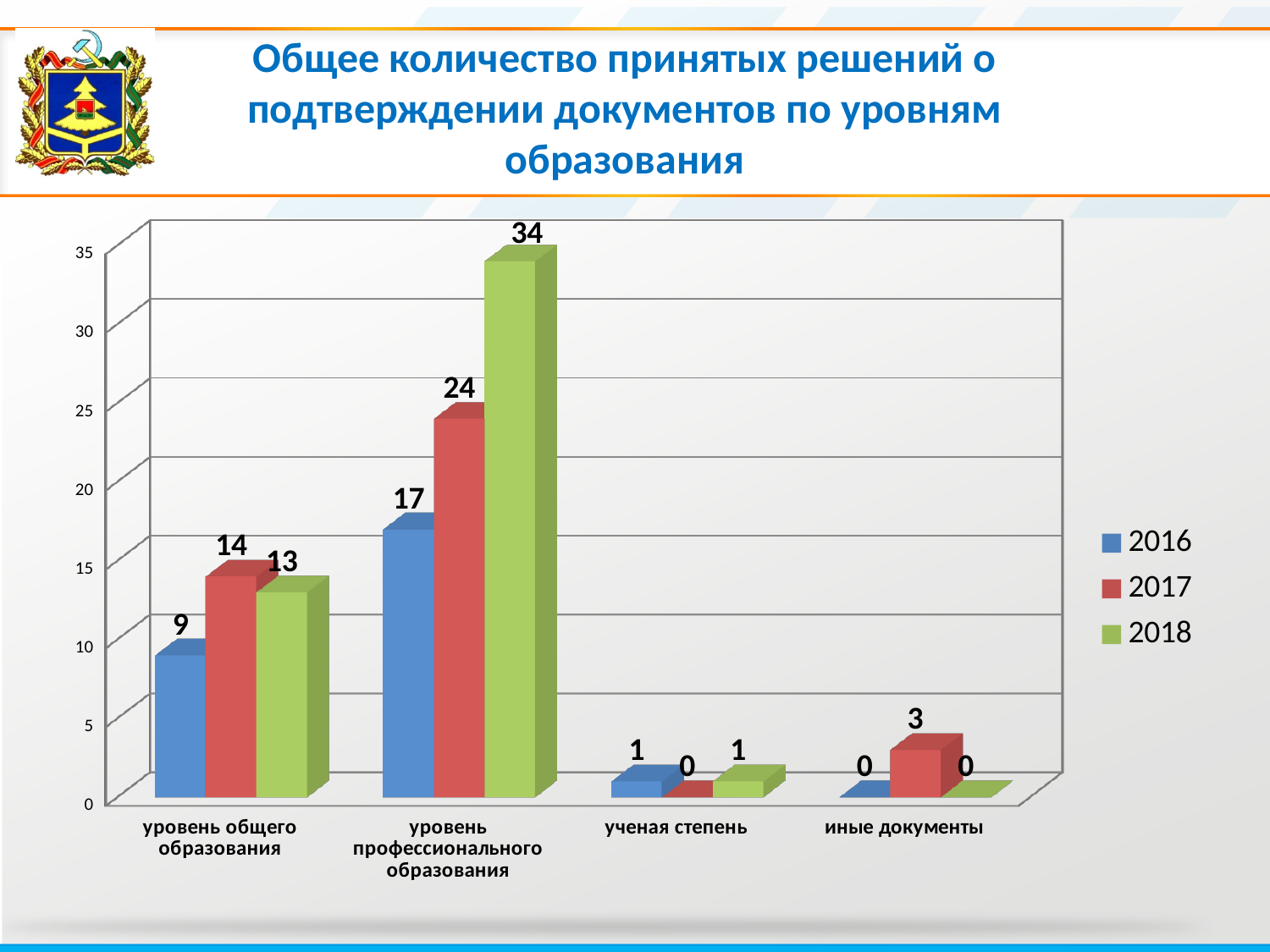
Do the values for 'уровень профессионального образования' rise or fall from 2016 to 2018? rise What is the value for 2016 in the category 'уровень общего образования'? 9 What kind of chart is shown on the slide? bar chart How many series does the legend list? 3 Which is larger in 'уровень общего образования': the value for 2017 or for 2018? 2017 What is the value for 2017 in the category 'иные документы'? 3 Which category has the lowest value for 2016? иные документы What is the difference between the 2018 and 2017 values for 'уровень профессионального образования'? 10 Which colour represents the 2018 series in the legend? green How many categories are shown on the x axis? 4 What is the value for 2018 in the category 'уровень профессионального образования'? 34 Which category has the highest value for 2017? уровень профессионального образования